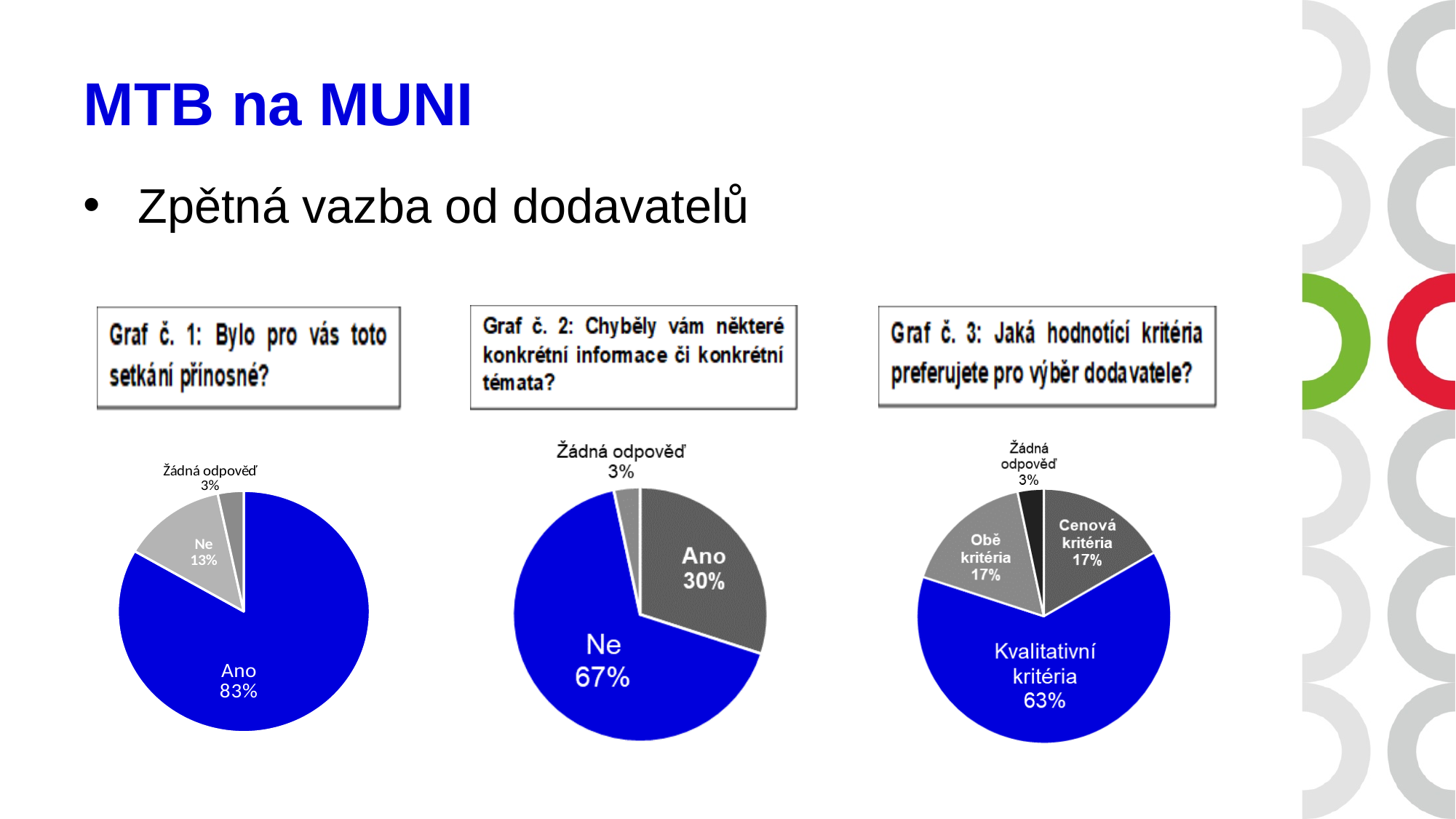
In Graf č. 3 (Jaká hodnotící kritéria preferujete pro výběr dodavatele?), what percentage is shown for "Cenová kritéria"? 17% In Graf č. 3 (Jaká hodnotící kritéria preferujete pro výběr dodavatele?), how many slices does the pie have? 4 In Graf č. 2 (Chyběly vám některé konkrétní informace či konkrétní témata?), what percentage answered "Ne"? 67% How many charts are shown on the slide? 3 In Graf č. 3 (Jaká hodnotící kritéria preferujete pro výběr dodavatele?), what share is shown for "Kvalitativní kritéria"? 63% In Graf č. 1 (Bylo pro vás toto setkání přínosné?), which slice is the smallest? Žádná odpověď In Graf č. 2 (Chyběly vám některé konkrétní informace či konkrétní témata?), what is the difference between the "Ne" and "Ano" shares? 37% In Graf č. 2 (Chyběly vám některé konkrétní informace či konkrétní témata?), which slice is the largest? Ne In Graf č. 1 (Bylo pro vás toto setkání přínosné?), what percentage is shown for "Ne"? 13% In Graf č. 1 (Bylo pro vás toto setkání přínosné?), what share of respondents answered "Ano"? 83% What type of chart is Graf č. 1 (Bylo pro vás toto setkání přínosné?)? Pie chart In Graf č. 3 (Jaká hodnotící kritéria preferujete pro výběr dodavatele?), which is larger: "Kvalitativní kritéria" or "Obě kritéria"? Kvalitativní kritéria